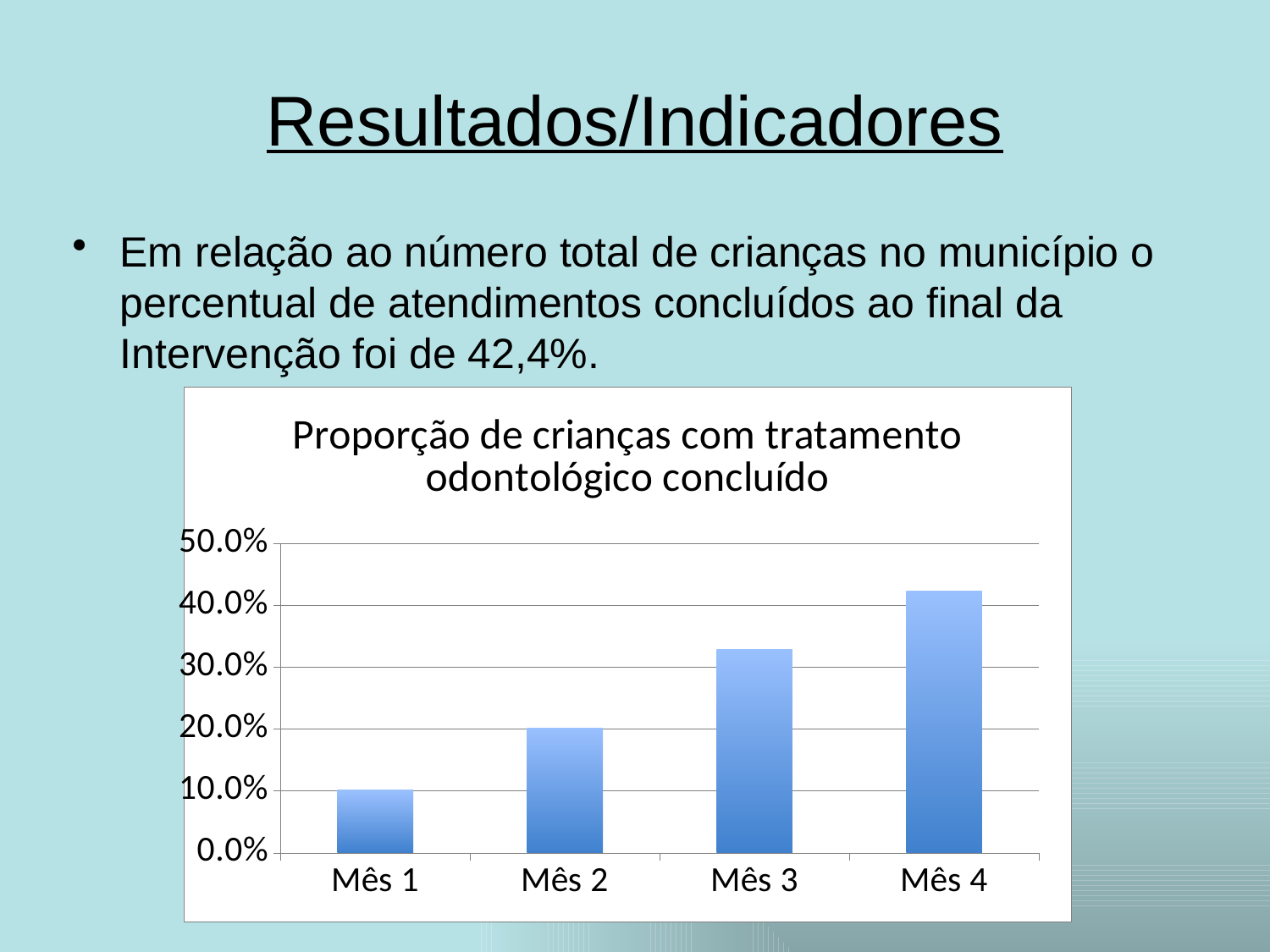
Which month has the lowest proportion of children with completed dental treatment? Mês 1 Do the values rise or fall from Mês 1 to Mês 4? rise Is the value for Mês 3 greater or less than 30.0%? greater What is the title of the chart? Proporção de crianças com tratamento odontológico concluído Is the value for Mês 4 greater or less than 50.0%? less Is the value for Mês 4 greater or less than 40.0%? greater How many months (categories) are shown on the x axis of the chart? 4 Which month has the highest proportion of children with completed dental treatment? Mês 4 Which is larger, the value for Mês 3 or the value for Mês 2? Mês 3 What kind of chart is shown on the slide? bar chart